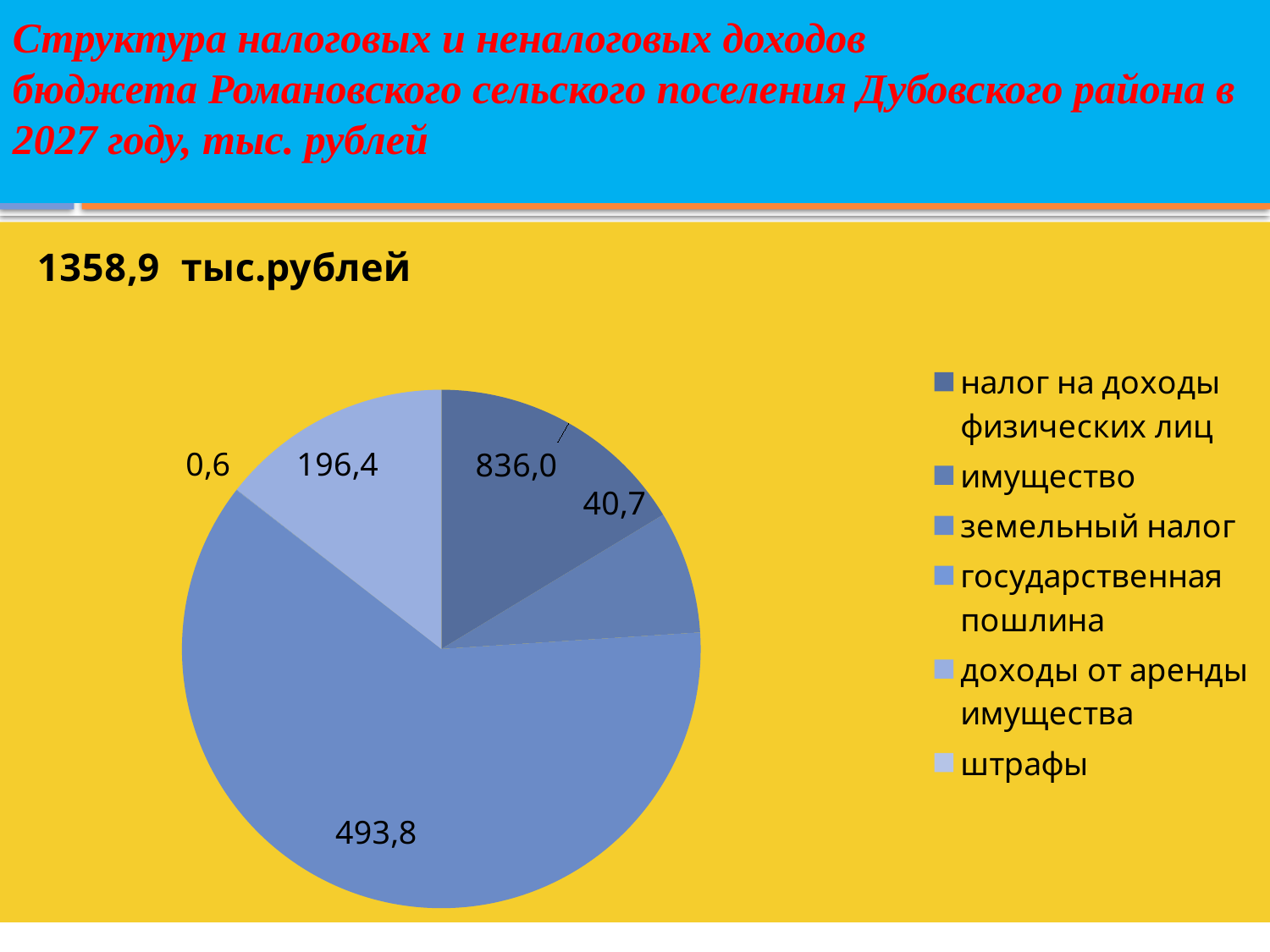
How many data labels are printed on the pie chart? 5 What kind of chart is shown on the slide? pie chart What value is labelled on the slice for налог на доходы физических лиц? 836,0 What value is labelled on the slice for имущество? 40,7 What value is labelled on the slice for доходы от аренды имущества? 196,4 What value is labelled on the slice for земельный налог? 493,8 What total amount is printed above the pie chart? 1358,9 тыс.рублей Which year does the chart title refer to? 2027 How many entries does the legend of the pie chart list? 6